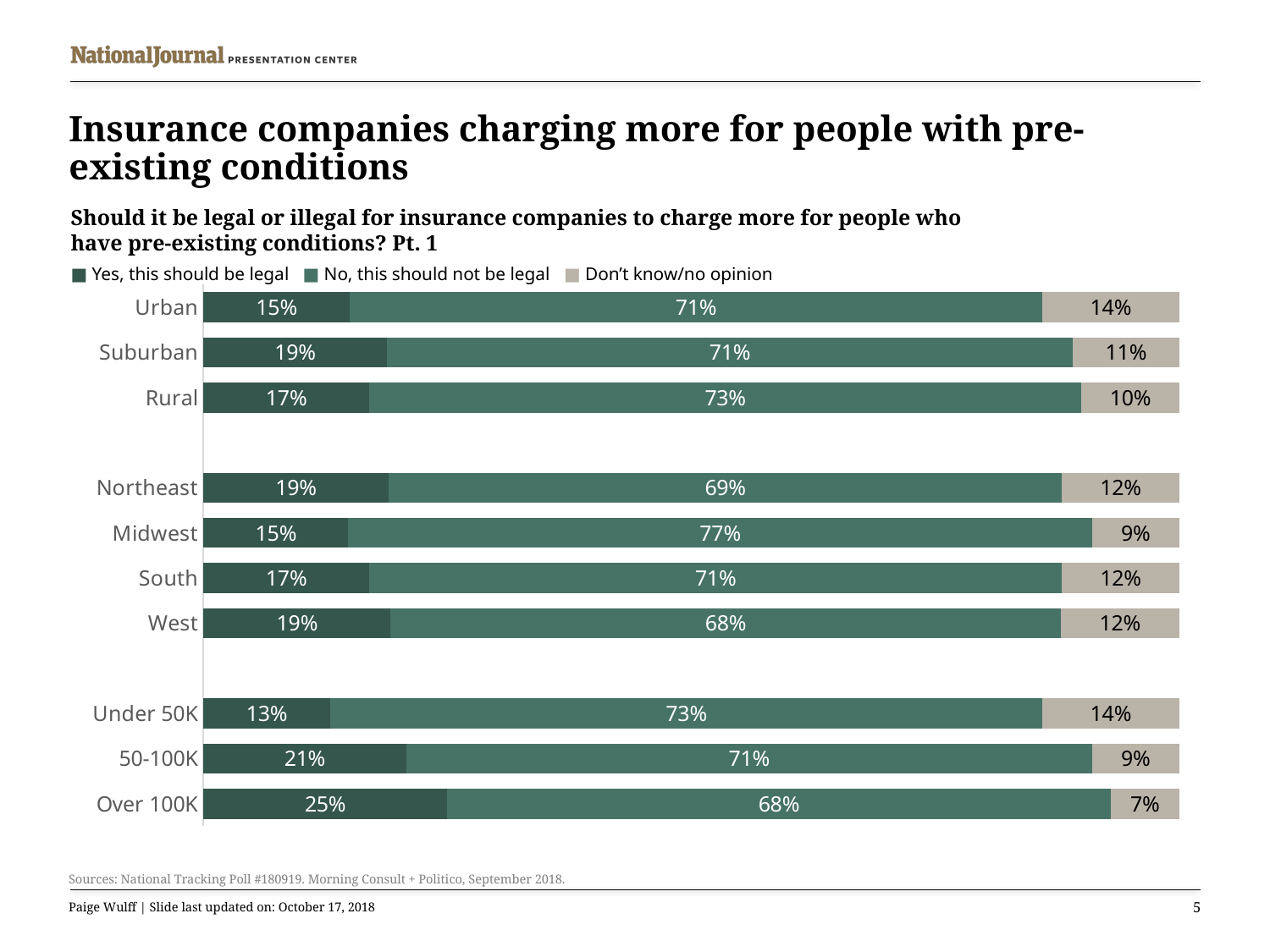
What percentage of Over 100K respondents said 'Yes, this should be legal'? 25% What is the 'Don't know/no opinion' value for the Midwest? 9% What percentage of Urban respondents said 'No, this should not be legal'? 71% How many categories are shown on the chart? 10 What kind of chart is shown on the slide? Stacked bar chart Which category has the highest 'No, this should not be legal' value? Midwest What is the total of the three segments in the Urban bar? 100% How many series does the legend list? 3 Which is larger: the 'No, this should not be legal' value for Rural or for West? Rural Which category has the lowest 'Yes, this should be legal' value? Under 50K What is the difference in percentage points between the 'Yes, this should be legal' values for Over 100K and Under 50K? 12 percentage points Which category has the lowest 'Don't know/no opinion' value? Over 100K